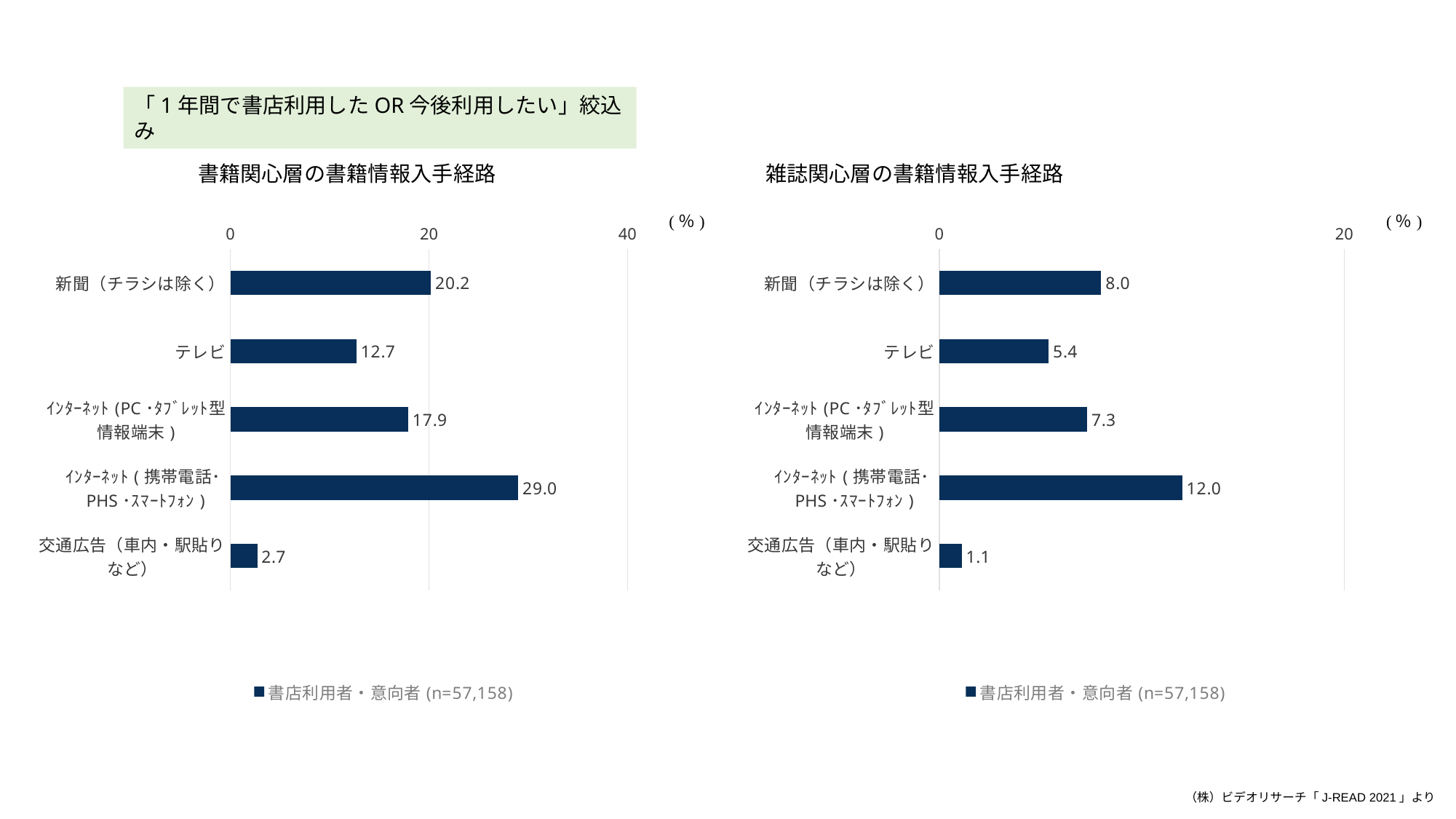
In the left chart (書籍関心層の書籍情報入手経路), which category has the highest value? インターネット（携帯電話・PHS・スマートフォン） In the left chart (書籍関心層の書籍情報入手経路), what is the value for 新聞（チラシは除く）? 20.2 In the right chart (雑誌関心層の書籍情報入手経路), what is the difference between the values for 新聞（チラシは除く） and 交通広告（車内・駅貼りなど）? 6.9 In the right chart (雑誌関心層の書籍情報入手経路), what is the value for テレビ? 5.4 How many categories are shown in the left chart (書籍関心層の書籍情報入手経路)? 5 How many series does the legend of the left chart (書籍関心層の書籍情報入手経路) list? 1 In the left chart (書籍関心層の書籍情報入手経路), which category has the lowest value? 交通広告（車内・駅貼りなど） What is the legend entry shown under the right chart (雑誌関心層の書籍情報入手経路)? 書店利用者・意向者 (n=57,158) What kind of chart is the right chart (雑誌関心層の書籍情報入手経路)? Bar chart In the left chart (書籍関心層の書籍情報入手経路), what is the difference between the values for インターネット（携帯電話・PHS・スマートフォン） and テレビ? 16.3 In the right chart (雑誌関心層の書籍情報入手経路), which is larger, the value for 新聞（チラシは除く） or the value for インターネット（PC・タブレット型情報端末）? 新聞（チラシは除く） In the right chart (雑誌関心層の書籍情報入手経路), which category has the highest value? インターネット（携帯電話・PHS・スマートフォン）